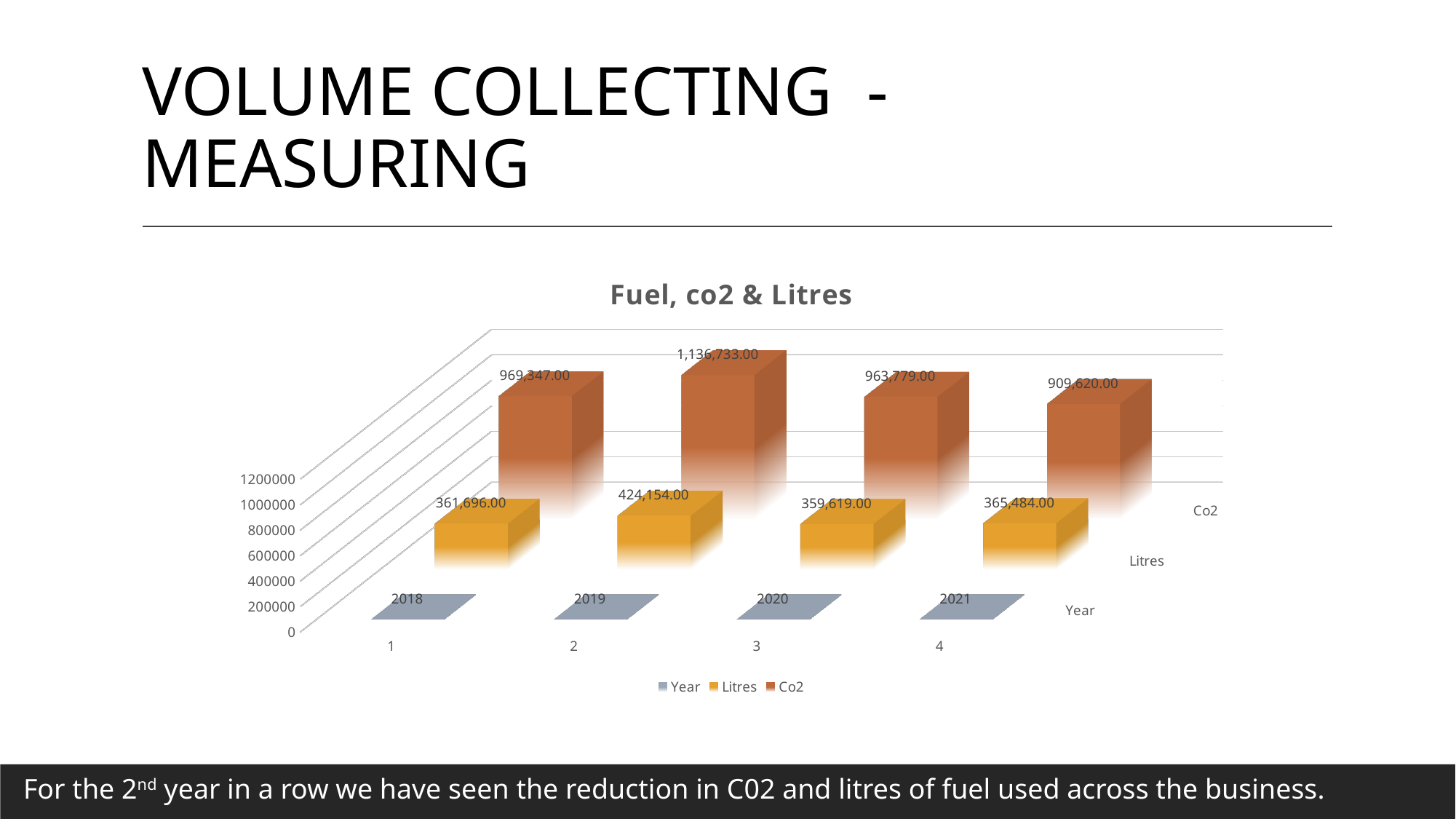
Which category has the lowest Litres value? 3 (2020) What is the Co2 value for category 3 (2020)? 963,779.00 What is the difference between the Co2 values for category 2 (2019) and category 1 (2018)? 167,386.00 What is the title of the chart? Fuel, co2 & Litres Which category has the highest Co2 value? 2 (2019) What is the Litres value for category 1 (2018)? 361,696.00 How many series does the legend list? 3 What is the Co2 value for category 2 (2019)? 1,136,733.00 How many categories are shown on the x axis? 4 What is the difference between the Litres values for category 2 (2019) and category 3 (2020)? 64,535.00 Which is larger, the Co2 value for category 3 (2020) or for category 4 (2021)? Category 3 (2020) What is the Litres value for category 4 (2021)? 365,484.00